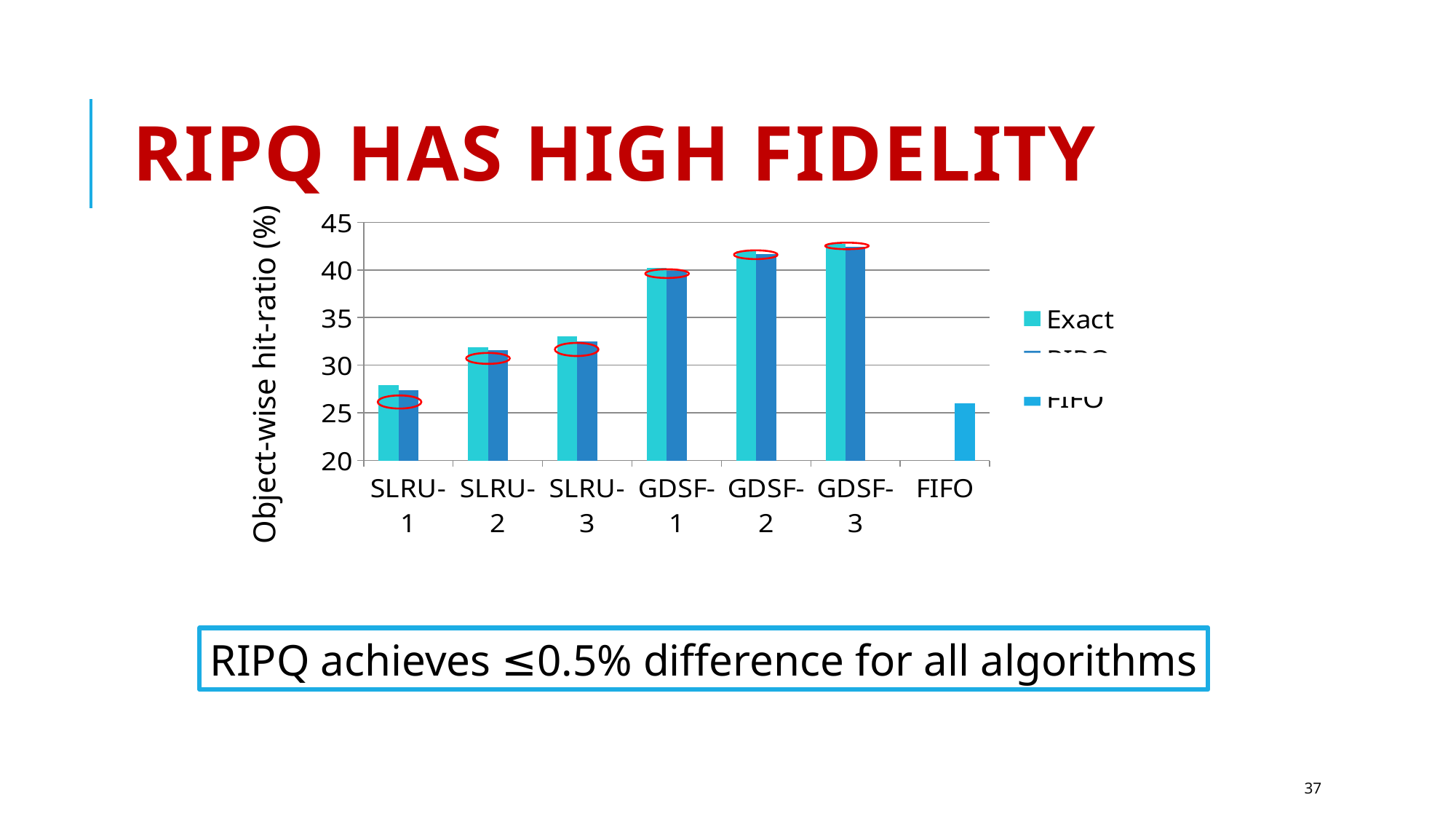
Which category has the lowest Exact value? SLRU-1 Is the Exact value for GDSF-3 greater or less than 40? greater What is the label of the chart's vertical axis? Object-wise hit-ratio (%) Which category has the highest Exact value? GDSF-3 Is the Exact value for SLRU-1 greater or less than 30? less Do the Exact values rise or fall going from SLRU-1 to GDSF-3 along the x axis? rise How many series does the chart's legend list? 3 How many categories are shown on the x axis of the chart? 7 Which has a larger Exact value, SLRU-2 or GDSF-2? GDSF-2 Is the FIFO value greater or less than 30? less What kind of chart is shown on the slide? bar chart